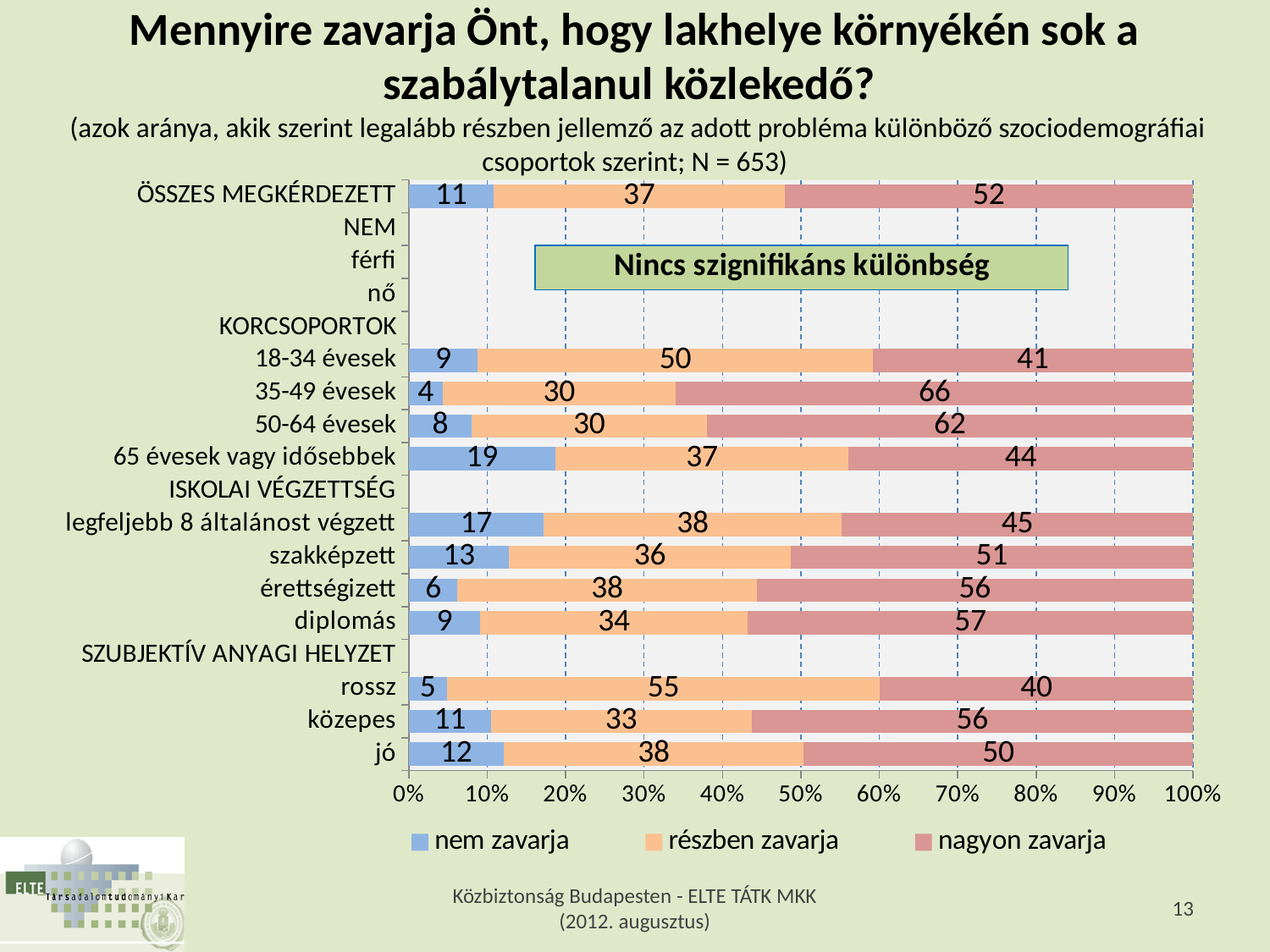
What kind of chart is shown on the slide? stacked bar chart Which category has the highest value for "részben zavarja"? rossz What is the value of "nem zavarja" for 65 évesek vagy idősebbek? 19 What is the total of the three segments for 18-34 évesek? 100 What is the value of "részben zavarja" for rossz? 55 What is the difference between the "nagyon zavarja" values for 35-49 évesek and 18-34 évesek? 25 Which is larger: the "nagyon zavarja" value for diplomás or for érettségizett? diplomás Which category has the highest value for "nagyon zavarja"? 35-49 évesek How many series does the legend list? 3 Which category has the lowest value for "nem zavarja"? 35-49 évesek What is the value of "nagyon zavarja" for ÖSSZES MEGKÉRDEZETT? 52 What text is shown in the green box inside the chart? Nincs szignifikáns különbség